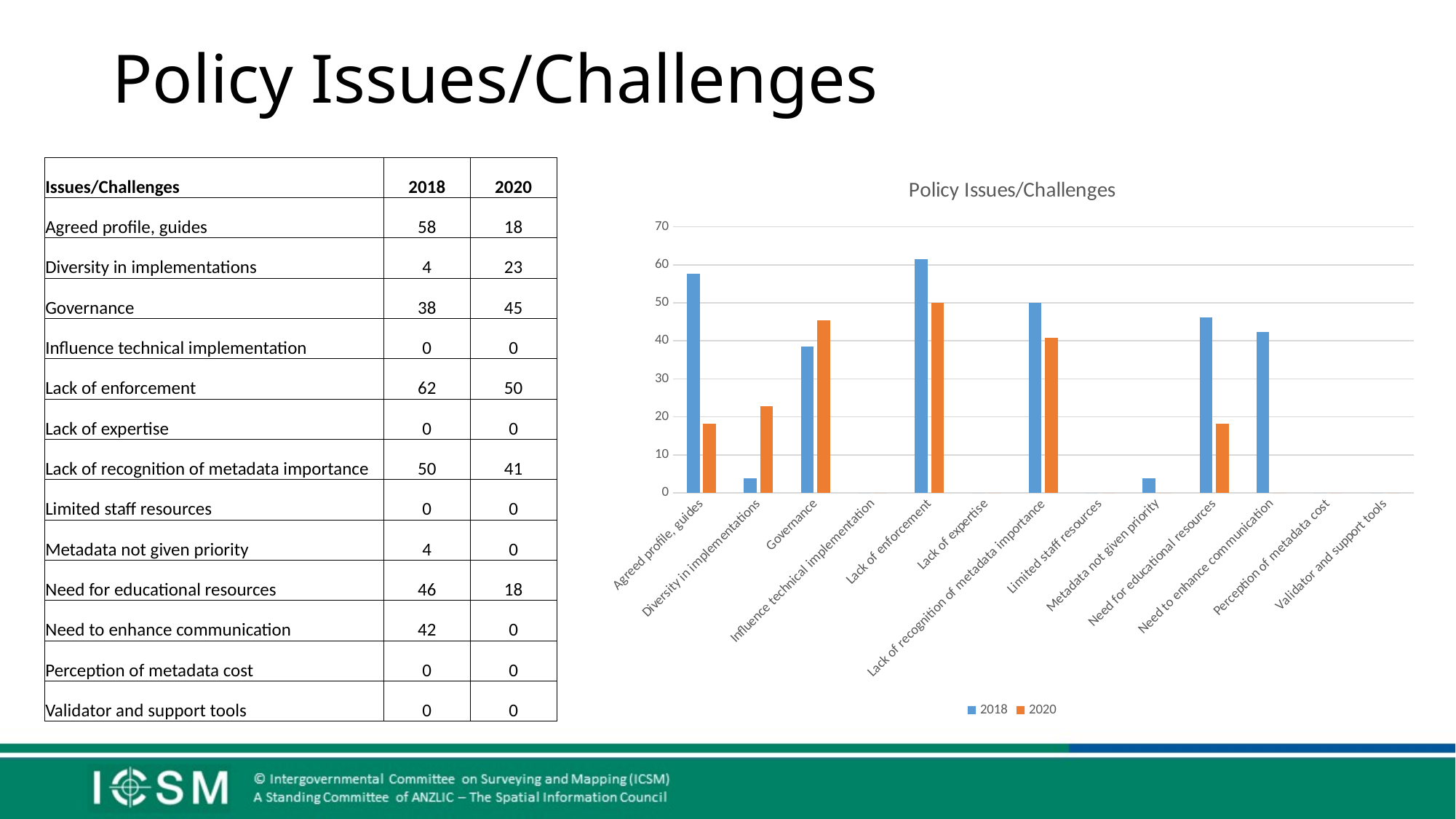
Which category has the highest 2020 value? Lack of enforcement How many series does the chart legend list? 2 How many categories are shown on the x axis of the chart? 13 What is the 2018 value for Lack of enforcement? 62 Which is larger for Governance, the 2018 value or the 2020 value? 2020 Which category has the highest 2018 value? Lack of enforcement What is the title of the chart? Policy Issues/Challenges Is the 2018 value for Need for educational resources greater or less than 40? greater What type of chart is shown on the slide? bar chart What is the 2020 value for Governance? 45 What is the 2020 value for Diversity in implementations? 23 What is the difference between the 2018 and 2020 values for Agreed profile, guides? 40